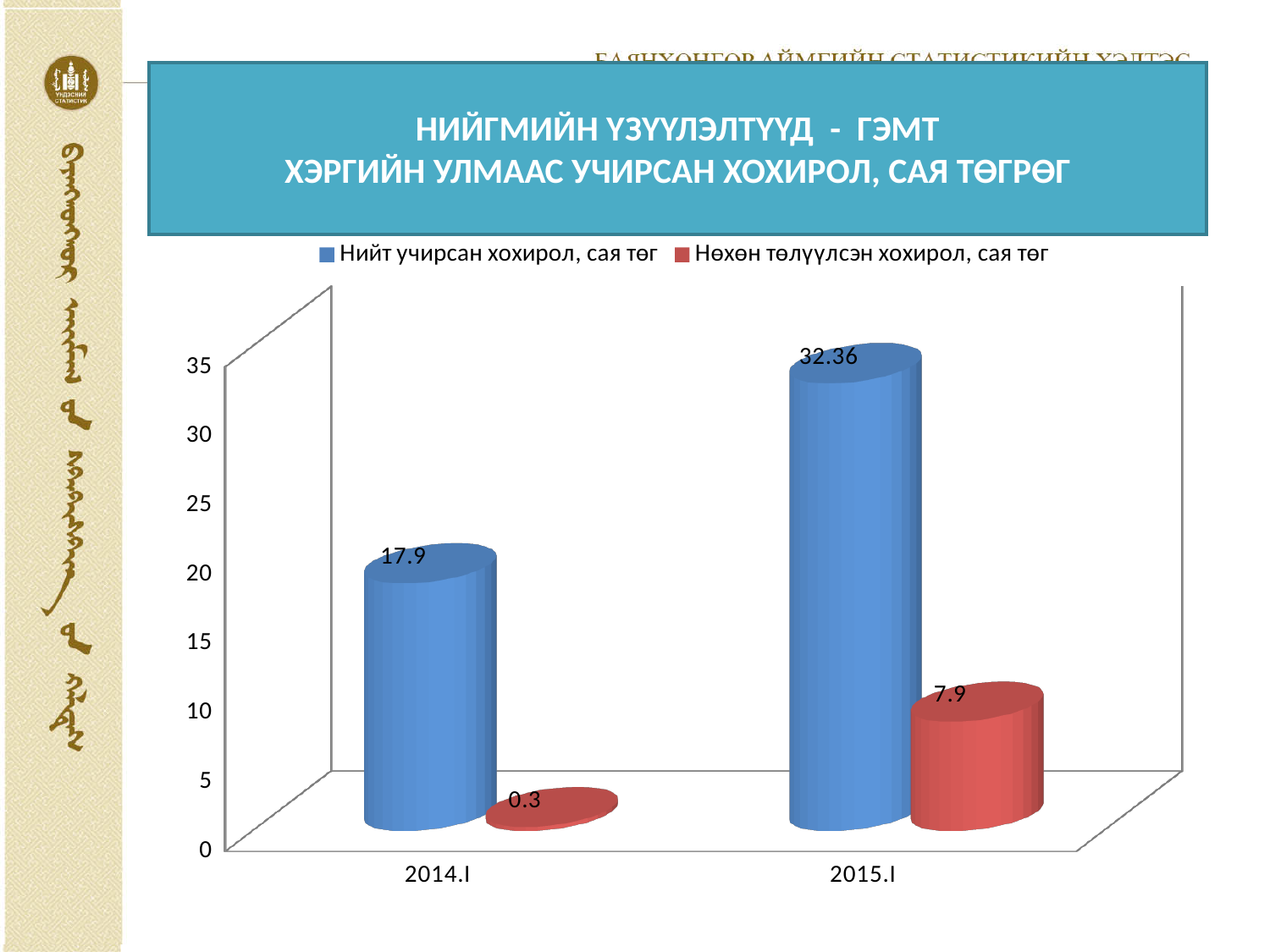
How many series does the legend list? 2 Which period has the lowest value for 'Нөхөн төлүүлсэн хохирол, сая төг'? 2014.I What is the value of 'Нөхөн төлүүлсэн хохирол, сая төг' for 2015.I? 7.9 What kind of chart is shown on the slide? Bar chart What is the value of 'Нөхөн төлүүлсэн хохирол, сая төг' for 2014.I? 0.3 What is the value of 'Нийт учирсан хохирол, сая төг' for 2015.I? 32.36 What is the difference between the 'Нөхөн төлүүлсэн хохирол, сая төг' values for 2015.I and 2014.I? 7.6 How many periods are shown on the x axis? 2 What is the difference between the 'Нийт учирсан хохирол, сая төг' values for 2015.I and 2014.I? 14.46 What is the value of 'Нийт учирсан хохирол, сая төг' for 2014.I? 17.9 Is the value of 'Нийт учирсан хохирол, сая төг' for 2015.I greater or less than 30? greater Which period has the higher value for 'Нийт учирсан хохирол, сая төг'? 2015.I